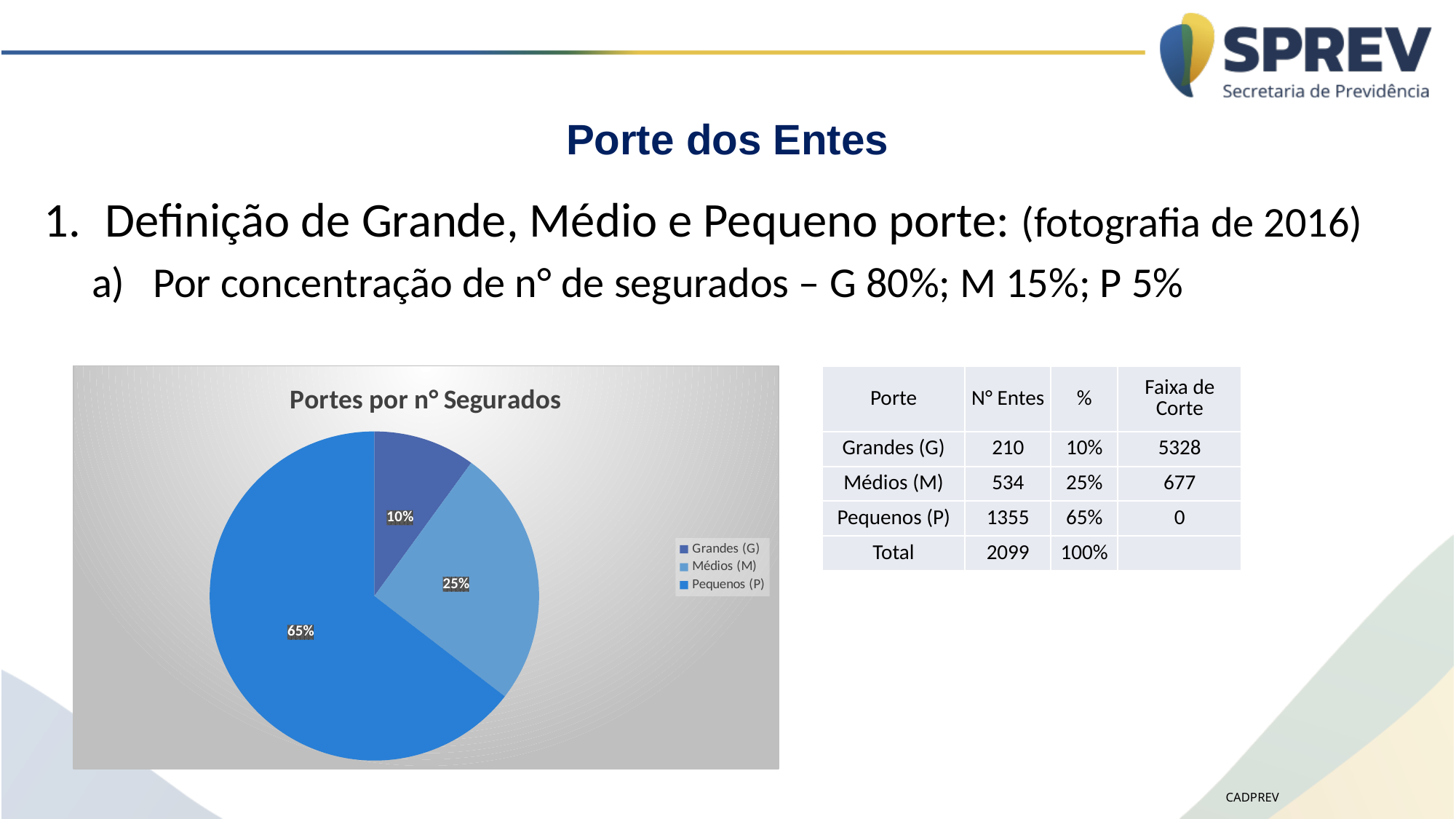
What is the title of the chart? Portes por n° Segurados Which category has the smallest slice of the pie? Grandes (G) How many entries does the legend list? 3 What percentage does the Grandes (G) slice show? 10% What is the difference in percentage points between the Pequenos (P) and Médios (M) slices? 40 What is the combined share of the Grandes (G) and Médios (M) slices? 35% Which category has the largest slice of the pie? Pequenos (P) What percentage does the Pequenos (P) slice show? 65% Which slice is larger, Médios (M) or Grandes (G)? Médios (M) How many slices does the pie chart have? 3 What type of chart is shown on the slide? pie chart What percentage does the Médios (M) slice show? 25%